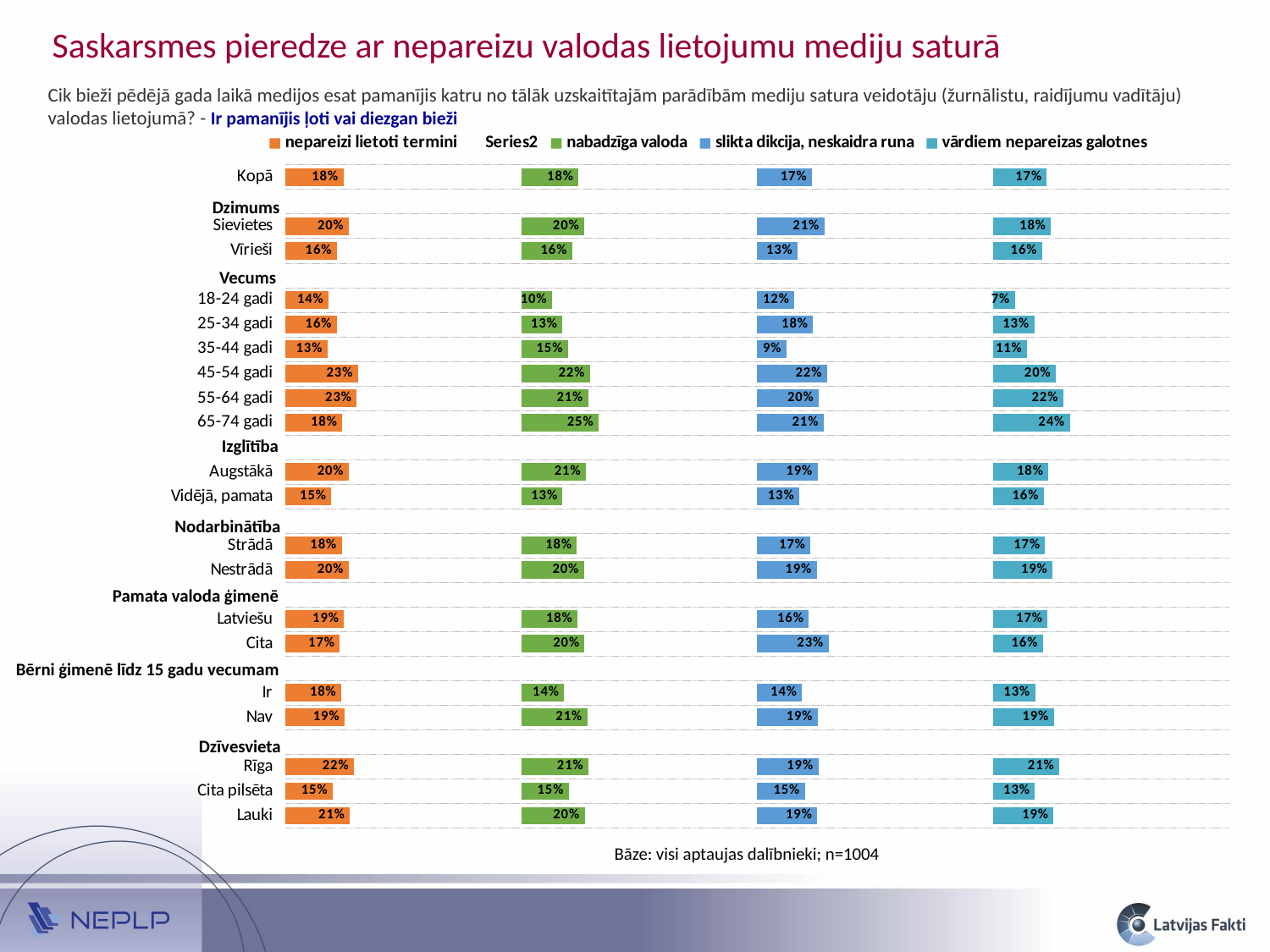
What is the value for '65-74 gadi' in the 'nabadzīga valoda' series? 25% What is the value for 'Kopā' in the 'nepareizi lietoti termini' series? 18% Which category has the highest value in the 'nabadzīga valoda' series? 65-74 gadi What is the difference between 'Sievietes' and 'Vīrieši' in the 'slikta dikcija, neskaidra runa' series? 8% How many entries does the chart legend list? 5 What kind of chart is shown on the slide? bar chart In the 'nepareizi lietoti termini' series, which is larger: 'Rīga' or 'Cita pilsēta'? Rīga What is the value for '18-24 gadi' in the 'vārdiem nepareizas galotnes' series? 7% Which category has the lowest value in the 'vārdiem nepareizas galotnes' series? 18-24 gadi What is the difference between 'Nav' and 'Ir' (Bērni ģimenē līdz 15 gadu vecumam) in the 'nabadzīga valoda' series? 7% What is the value for 'Cita' (Pamata valoda ģimenē) in the 'slikta dikcija, neskaidra runa' series? 23% Which category has the lowest value in the 'slikta dikcija, neskaidra runa' series? 35-44 gadi